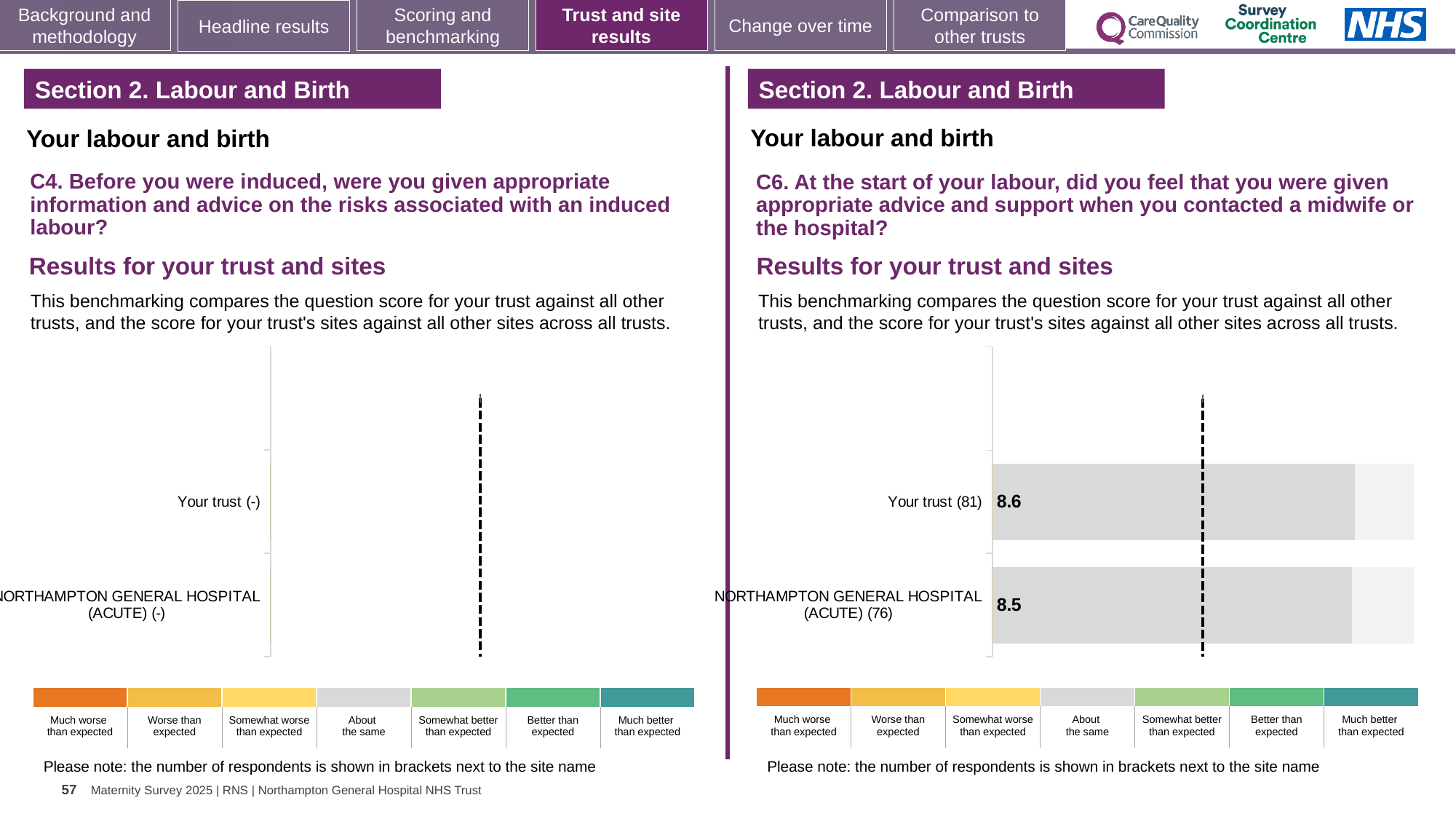
On the right-hand chart (C6), how many respondents are shown in brackets for Northampton General Hospital (Acute)? 76 What kind of chart is the right-hand chart (C6)? Bar chart On the left-hand chart (C4), what is shown in brackets next to Your trust? - On the right-hand chart (C6), how many respondents are shown in brackets for Your trust? 81 How many benchmark categories are shown in the colour key below each chart? 7 On the right-hand chart (C6), what is the score for Northampton General Hospital (Acute)? 8.5 On the right-hand chart (C6), which has the higher score, Your trust or Northampton General Hospital (Acute)? Your trust On the right-hand chart (C6), what is the difference between the score for Your trust and the score for Northampton General Hospital (Acute)? 0.1 On the right-hand chart (C6), what is the score for Your trust? 8.6 How many categories (rows) are plotted on the right-hand chart (C6)? 2 On the right-hand chart (C6), which has the lowest score? Northampton General Hospital (Acute) How many categories (rows) are listed on the left-hand chart (C4)? 2